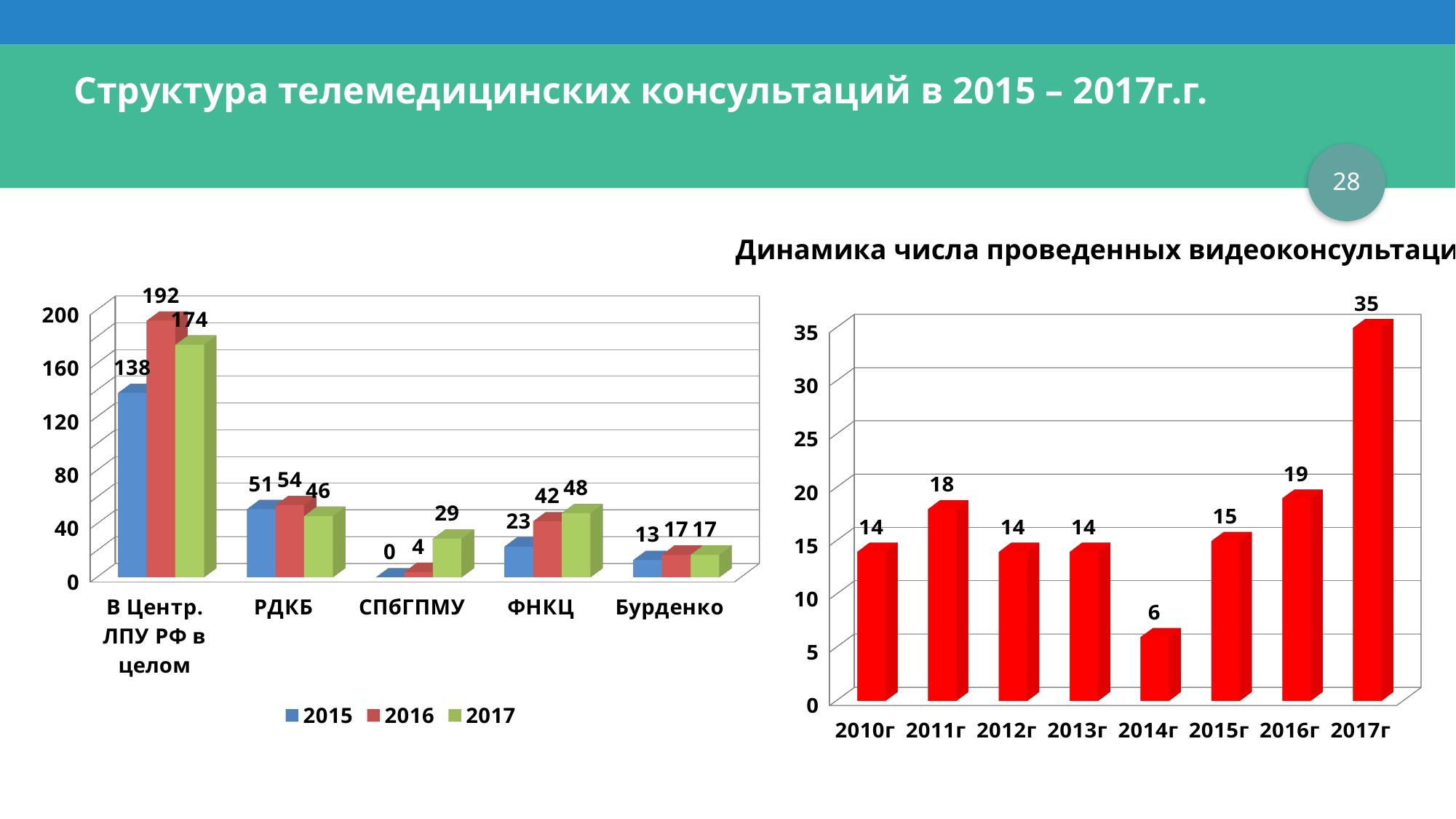
In the right chart, which year has the highest value? 2017г In the left chart, how many categories are shown on the x axis? 5 In the right chart, which year has the lowest value? 2014г What type of chart is the right chart? Bar chart In the left chart, which year has the highest value for В Центр. ЛПУ РФ в целом? 2016 In the right chart, what is the difference between the values for 2017г and 2016г? 16 In the left chart, how many series does the legend list? 3 In the left chart, what is the value for РДКБ in 2016? 54 In the left chart, which is larger: the 2017 value for РДКБ or the 2017 value for ФНКЦ? ФНКЦ In the left chart, what is the difference between the 2016 and 2015 values for ФНКЦ? 19 In the left chart, what is the value for СПбГПМУ in 2017? 29 In the right chart, what is the value for 2014г? 6